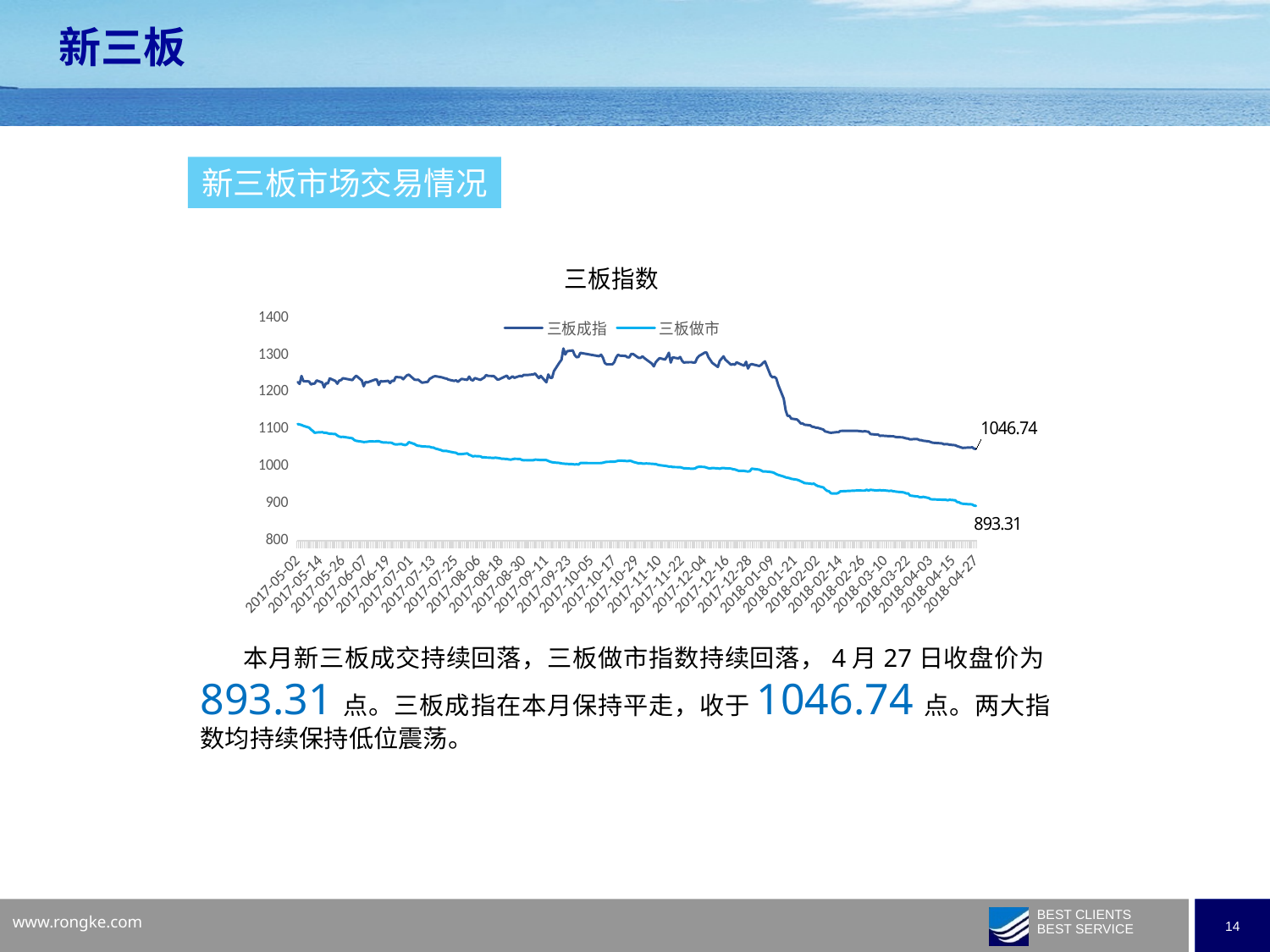
Which series has the higher value at 2018-04-27, 三板成指 or 三板做市? 三板成指 What is the title of the chart on the slide? 三板指数 What is the value of 三板成指 at the end of the series (2018-04-27)? 1046.74 What kind of chart is the 三板指数 chart? line chart How many series does the legend of the 三板指数 chart list? 2 What is the value of 三板做市 at the end of the series (2018-04-27)? 893.31 Does the 三板做市 line rise or fall from 2017-05-02 to 2018-04-27? fall Is the value of 三板成指 at 2018-02-14 greater or less than 1200? less Is the value of 三板做市 at 2017-05-02 greater or less than 1000? greater Is the value of 三板成指 at 2017-10-05 greater or less than 1200? greater Does the 三板成指 line rise or fall from 2017-05-02 to 2018-04-27? fall What is the difference between the final values of 三板成指 and 三板做市? 153.43